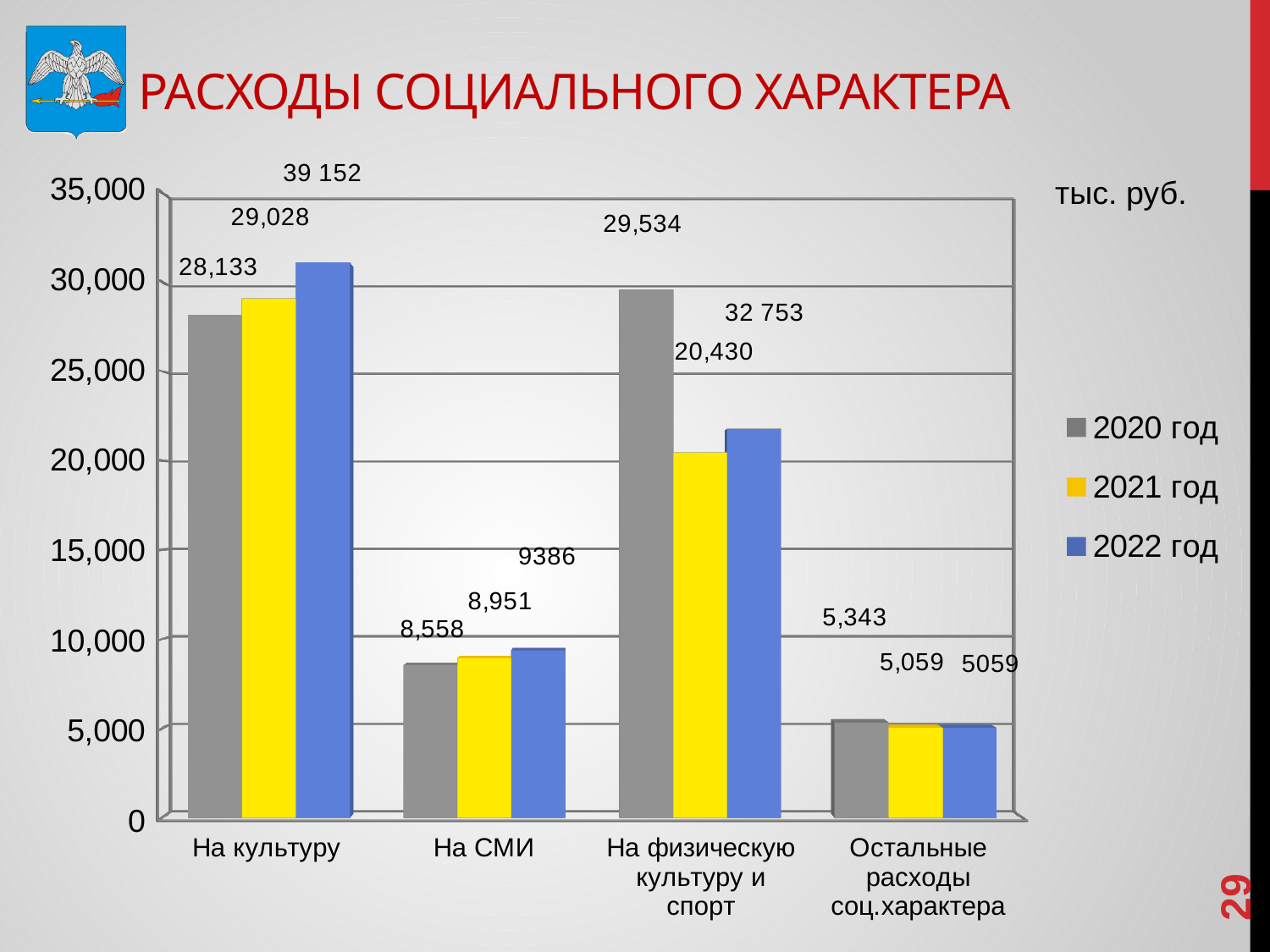
Is the value for 2022 год in the category На культуру greater or less than 30,000? greater What is the value for 2022 год in the category На СМИ? 9386 By how much does the 2020 год value exceed the 2021 год value for На физическую культуру и спорт? 9,104 How many categories are shown on the x axis? 4 Which category has the lowest value for 2020 год? Остальные расходы соц.характера How many series does the legend list? 3 For 2020 год, which is larger: На культуру or На физическую культуру и спорт? На физическую культуру и спорт What is the difference between the 2021 год and 2020 год values for На культуру? 895 What is the value for 2020 год in the category Остальные расходы соц.характера? 5,343 What is the value for 2020 год in the category На культуру? 28,133 What kind of chart is shown on the slide? bar chart What is the value for 2021 год in the category На физическую культуру и спорт? 20,430